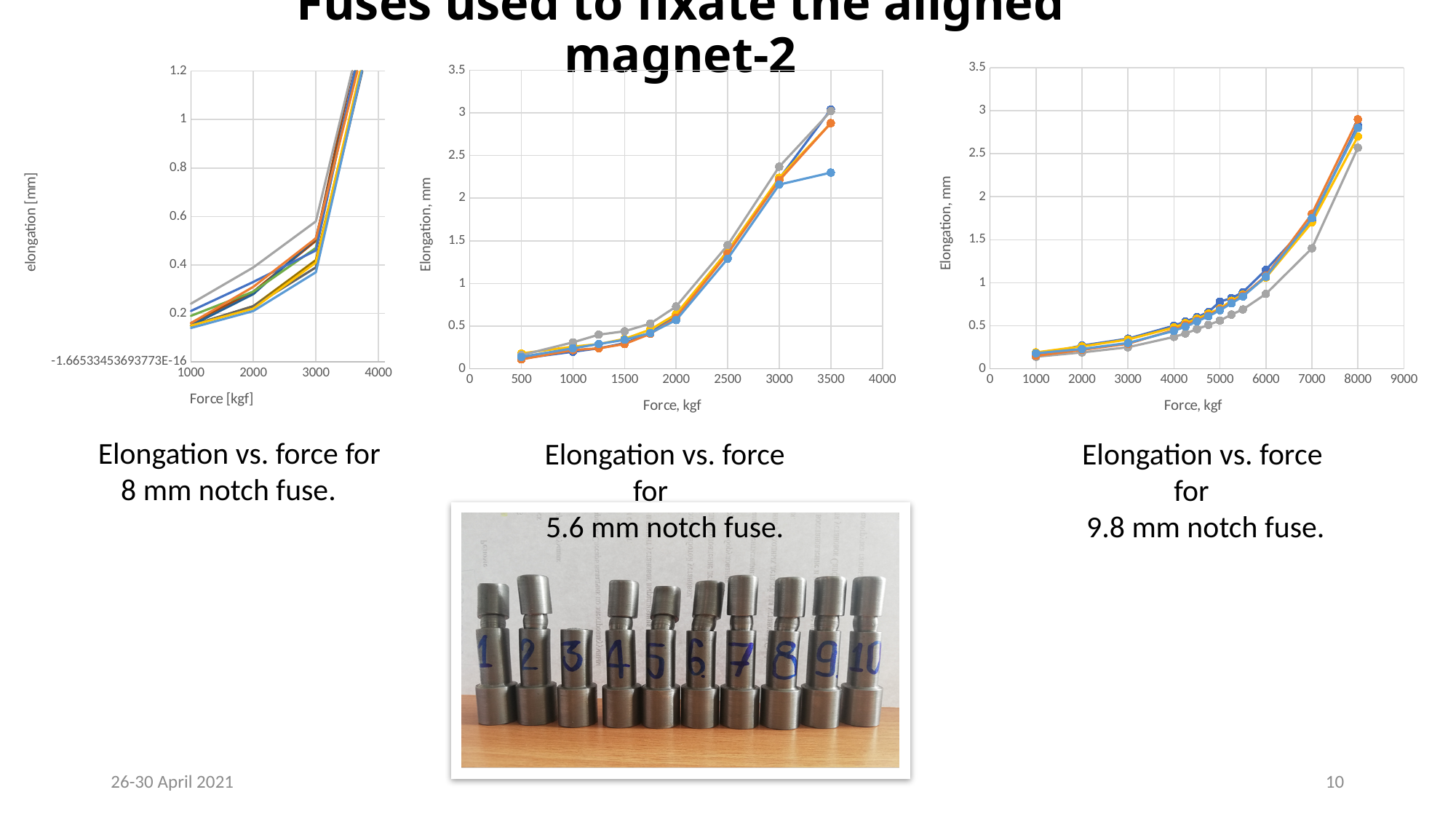
In the right chart (9.8 mm notch fuse), are the elongation values at 1000 kgf greater or less than 0.5 mm? less What is the label of the x axis on the middle chart (5.6 mm notch fuse)? Force, kgf In the right chart (Elongation vs. force for 9.8 mm notch fuse), do the elongation values rise or fall as force increases? rise In the right chart (9.8 mm notch fuse), are the elongation values at 8000 kgf greater or less than 2 mm? greater In the middle chart (5.6 mm notch fuse), are the elongation values at 3500 kgf greater or less than 2 mm? greater In the middle chart (Elongation vs. force for 5.6 mm notch fuse), do the elongation values rise or fall as force increases? rise What kind of chart is the left chart (Elongation vs. force for 8 mm notch fuse)? line chart What is the highest tick value shown on the x axis of the right chart (9.8 mm notch fuse)? 9000